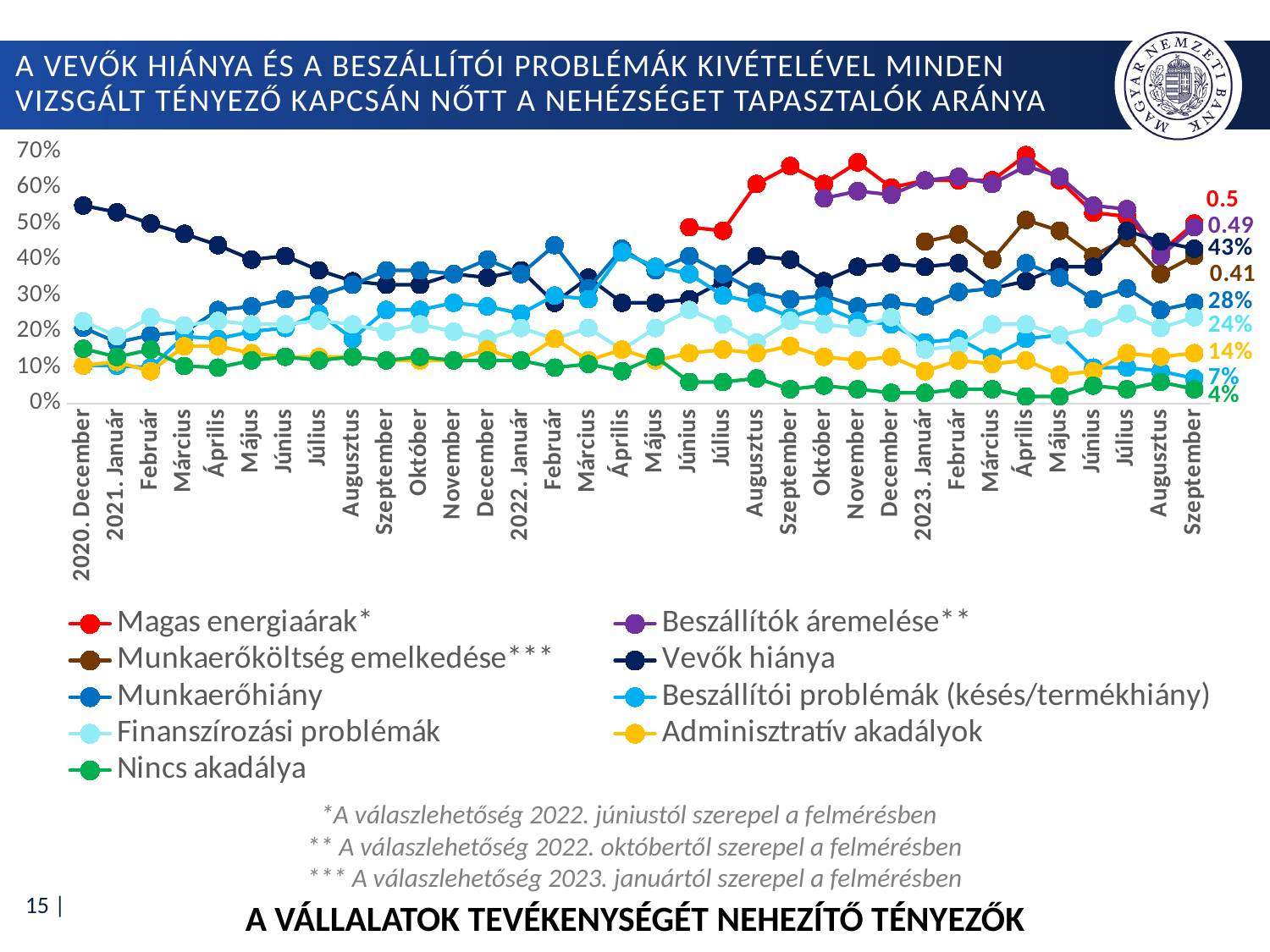
What is the value shown for Finanszírozási problémák at the last data point? 24% Does the Vevők hiánya series rise or fall overall from 2020 December to 2023 Szeptember? Fall Which series has the lowest value at the last data point (2023 Szeptember)? Nincs akadálya At the last data point, which is larger: Vevők hiánya or Munkaerőhiány? Vevők hiánya What is the value shown for Vevők hiánya at the last data point (2023 Szeptember)? 43% What is the value shown for Beszállítói problémák (késés/termékhiány) at the last data point? 7% What is the value shown for Munkaerőhiány at the last data point (2023 Szeptember)? 28% What is the value shown for Nincs akadálya at the last data point (2023 Szeptember)? 4% Is the value for Magas energiaárak in 2022 Szeptember greater or less than 60%? greater How many series does the legend list? 9 What kind of chart is shown on the slide? Line chart What is the difference between Vevők hiánya (43%) and Munkaerőhiány (28%) at the last data point? 15 percentage points